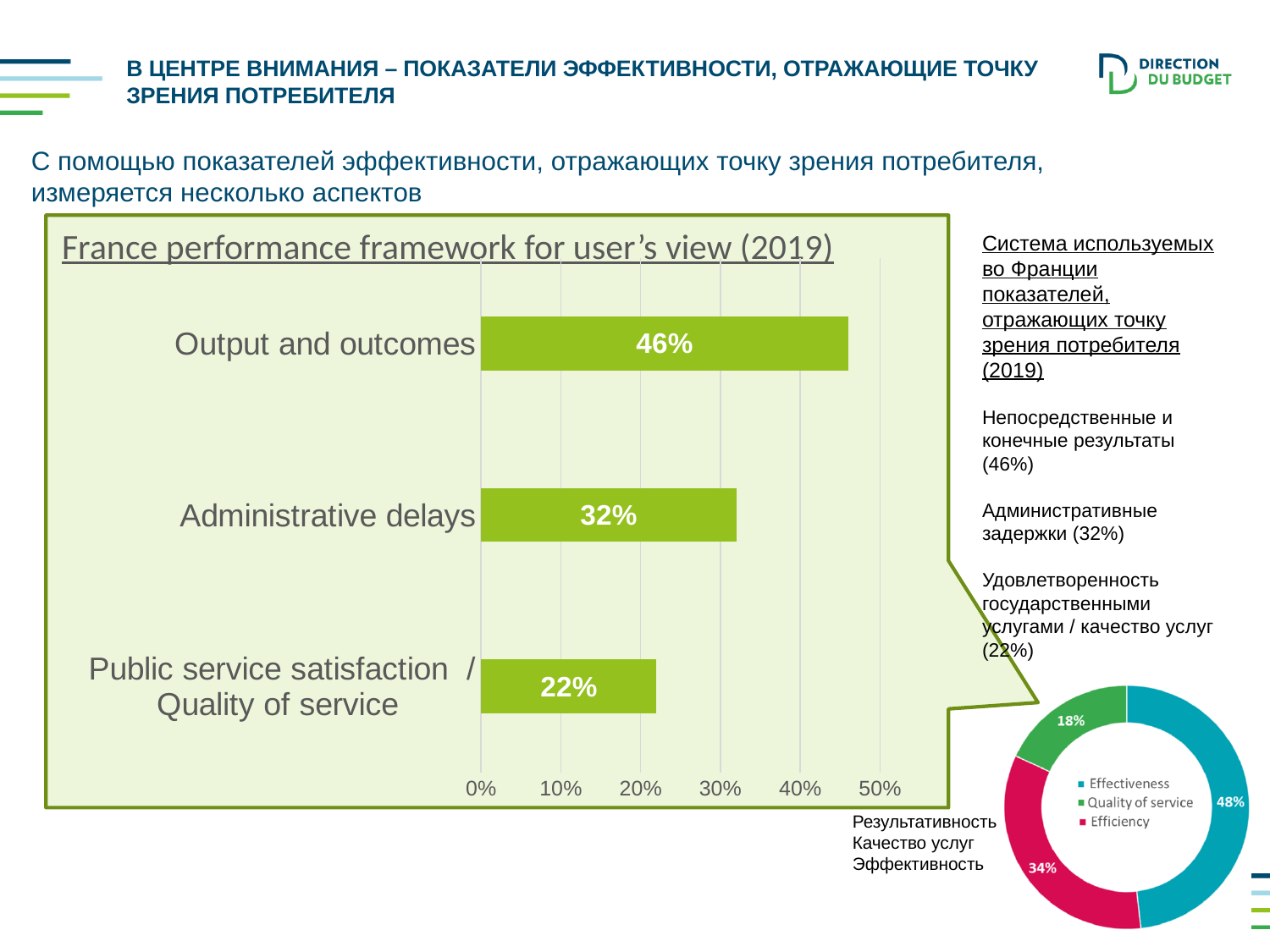
In the doughnut chart at the bottom right of the slide, which segment is the smallest? Quality of service In the doughnut chart at the bottom right of the slide, what share does Efficiency have? 34% In the chart titled "France performance framework for user's view (2019)", what is the value for Output and outcomes? 46% In the chart titled "France performance framework for user's view (2019)", what is the value for Public service satisfaction / Quality of service? 22% How many entries does the legend of the doughnut chart at the bottom right of the slide list? 3 In the chart titled "France performance framework for user's view (2019)", which category has the highest value? Output and outcomes In the chart titled "France performance framework for user's view (2019)", how many categories are shown? 3 In the chart titled "France performance framework for user's view (2019)", what is the difference between Output and outcomes and Administrative delays? 14% In the chart titled "France performance framework for user's view (2019)", what is the value for Administrative delays? 32% What kind of chart is the one titled "France performance framework for user's view (2019)"? Bar chart In the doughnut chart at the bottom right of the slide, what share does Effectiveness have? 48% In the chart titled "France performance framework for user's view (2019)", which category has the lowest value? Public service satisfaction / Quality of service